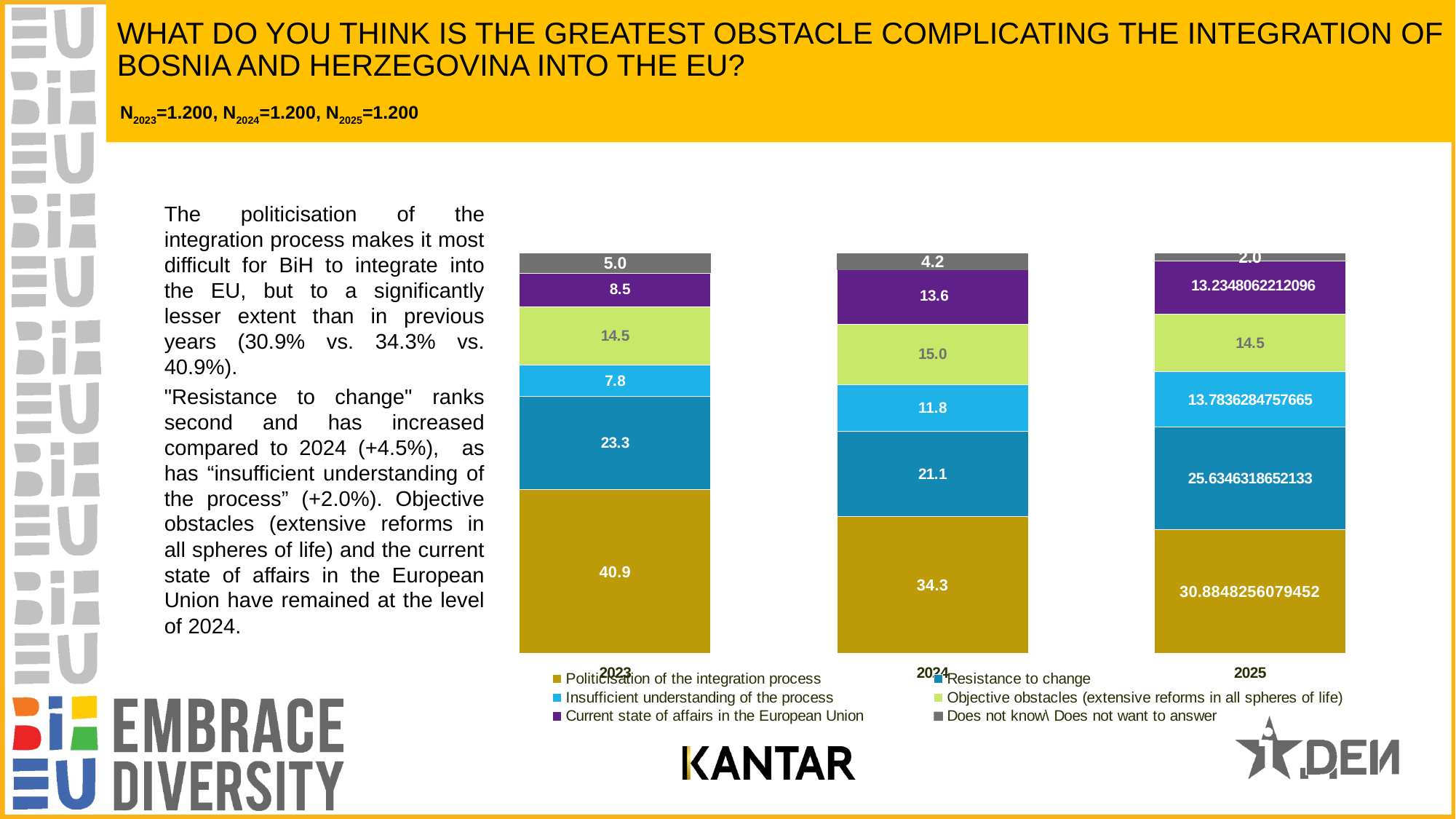
What is the value for "Resistance to change" in 2024? 21.1 What is the value for "Politicisation of the integration process" in 2023? 40.9 In 2024, which is larger: "Insufficient understanding of the process" or "Objective obstacles (extensive reforms in all spheres of life)"? Objective obstacles (extensive reforms in all spheres of life) Which category has the smallest value in the 2023 bar? Does not know\ Does not want to answer How many series does the chart legend list? 6 What is the difference between the 2023 and 2024 values for "Politicisation of the integration process"? 6.6 Which category has the largest value in the 2023 bar? Politicisation of the integration process What is the value for "Does not know\ Does not want to answer" in 2025? 2.0 Does the value for "Politicisation of the integration process" rise or fall from 2023 to 2025? fall What type of chart is shown on the slide? stacked bar chart What is the value for "Objective obstacles (extensive reforms in all spheres of life)" in 2025? 14.5 How many years (bars) are shown in the chart? 3